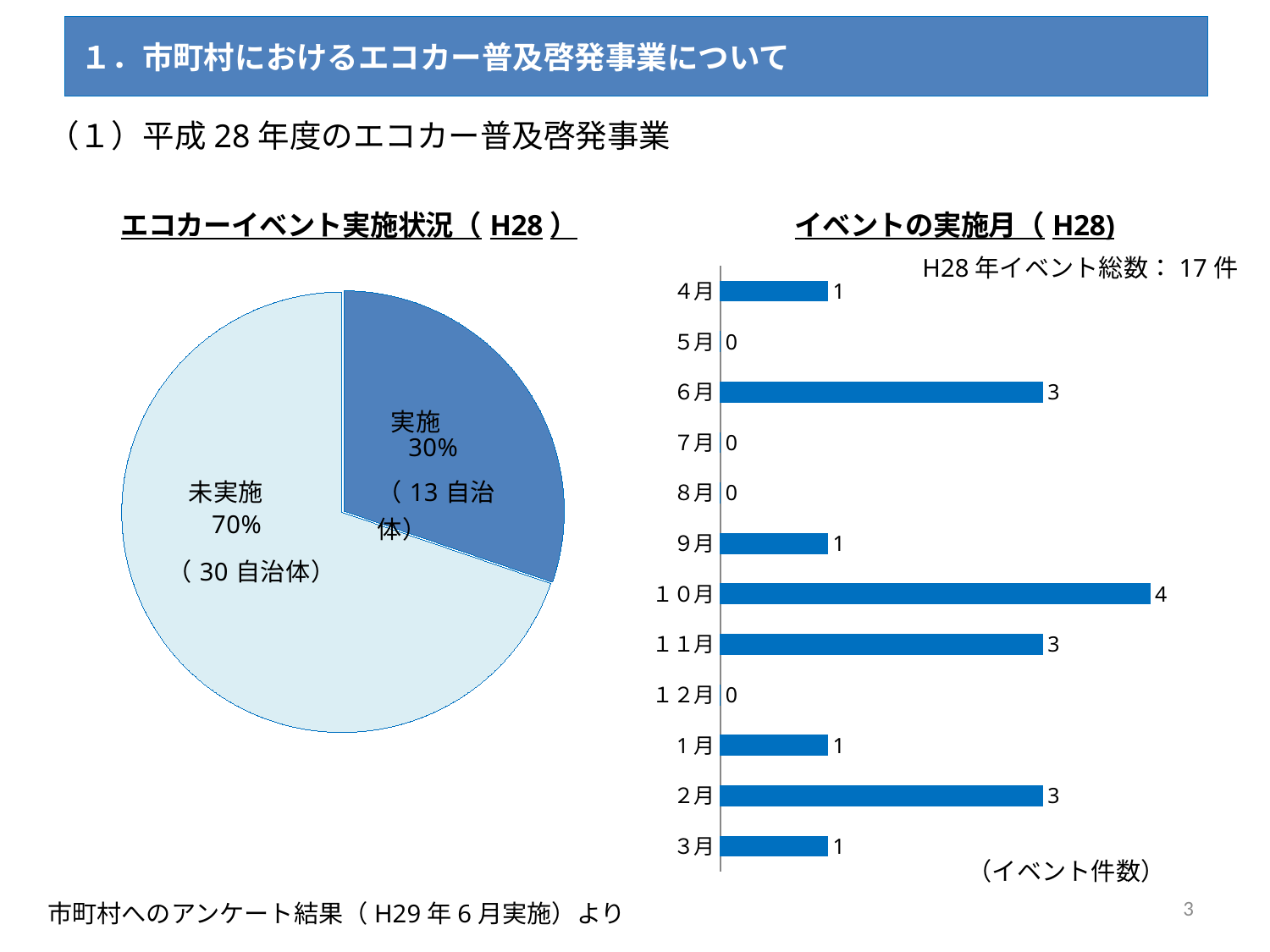
In the bar chart イベントの実施月（H28）, what is the value for 10月? 4 In the pie chart エコカーイベント実施状況（H28）, which slice is larger, 実施 or 未実施? 未実施 What kind of chart is the left chart, エコカーイベント実施状況（H28）? pie chart In the pie chart エコカーイベント実施状況（H28）, how many 自治体 are in the 未実施 slice? 30自治体 In the bar chart イベントの実施月（H28）, which month has the highest value? 10月 In the pie chart エコカーイベント実施状況（H28）, what share is labelled 実施? 30% In the bar chart イベントの実施月（H28）, what is the difference between the values for 10月 and 6月? 1 In the bar chart イベントの実施月（H28）, how many months have a value of 0? 4 According to the text above the bar chart イベントの実施月（H28）, what is the total number of events in H28? 17件 What kind of chart is the right chart, イベントの実施月（H28）? bar chart In the bar chart イベントの実施月（H28）, how many months are shown on the axis? 12 In the pie chart エコカーイベント実施状況（H28）, what share is labelled 未実施? 70%